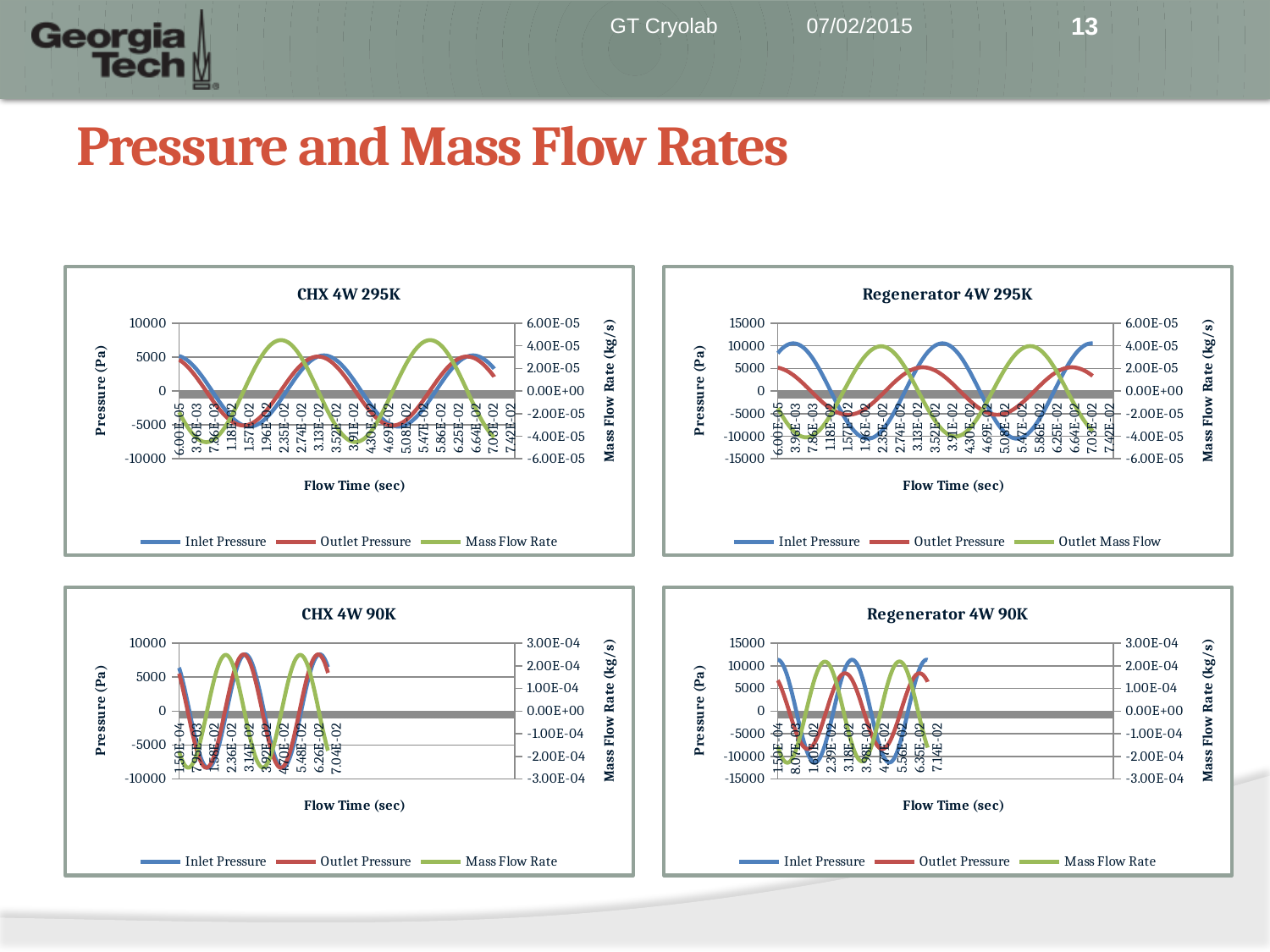
In 'Regenerator 4W 90K', is the peak Outlet Pressure greater or less than 15000? less How many charts are shown on the slide? 4 How many series does the legend of 'CHX 4W 90K' list? 3 What kind of chart is 'Regenerator 4W 90K'? line chart In 'CHX 4W 295K', is the peak Inlet Pressure greater or less than 10000? less What kind of chart is 'CHX 4W 295K'? line chart In 'Regenerator 4W 295K', which series reaches a higher peak, Inlet Pressure or Outlet Pressure? Inlet Pressure In 'Regenerator 4W 295K', is the peak Inlet Pressure greater or less than 5000? greater How many series does the legend of 'Regenerator 4W 295K' list? 3 In 'Regenerator 4W 295K', what is the third legend entry? Outlet Mass Flow What is the x-axis title of 'CHX 4W 90K'? Flow Time (sec)